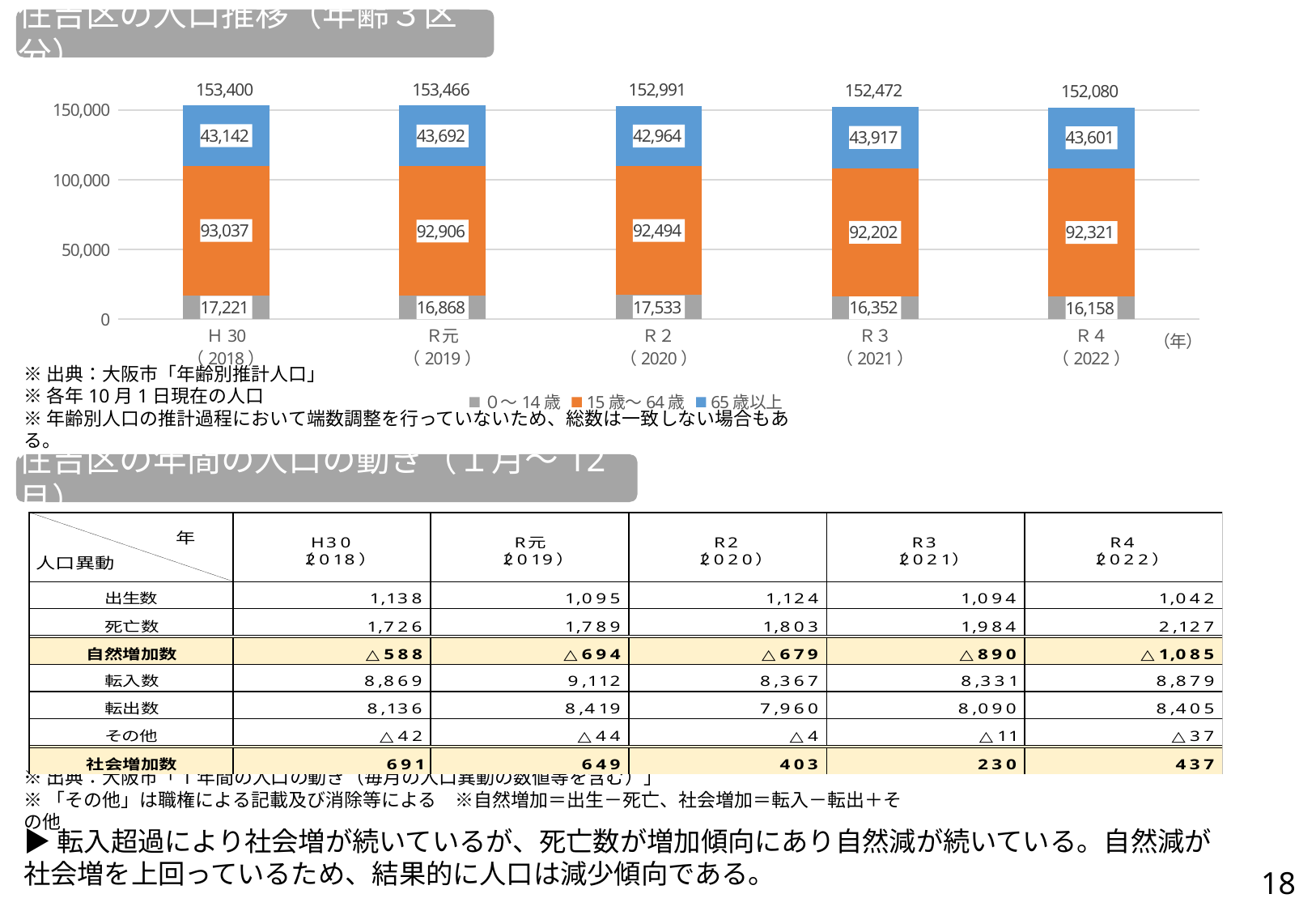
What is the value for 0～14歳 in R4 (2022)? 16,158 What is the difference between the 65歳以上 values for R3 (2021) and R2 (2020)? 953 What is the total population shown above the bar for R元 (2019)? 153,466 Which is larger, the 15歳～64歳 value in R元 (2019) or in R4 (2022)? R元 (2019) In which year is the total population shown above the bars lowest? R4 (2022) What is the value for 15歳～64歳 in H30 (2018)? 93,037 In which year is the 0～14歳 value highest? R2 (2020) What is the value for 65歳以上 in R2 (2020)? 42,964 How many years are plotted on the x axis of the chart? 5 What kind of chart is shown on the slide? Stacked bar chart How many series does the chart legend list? 3 Which series is shown in orange in the chart? 15歳～64歳